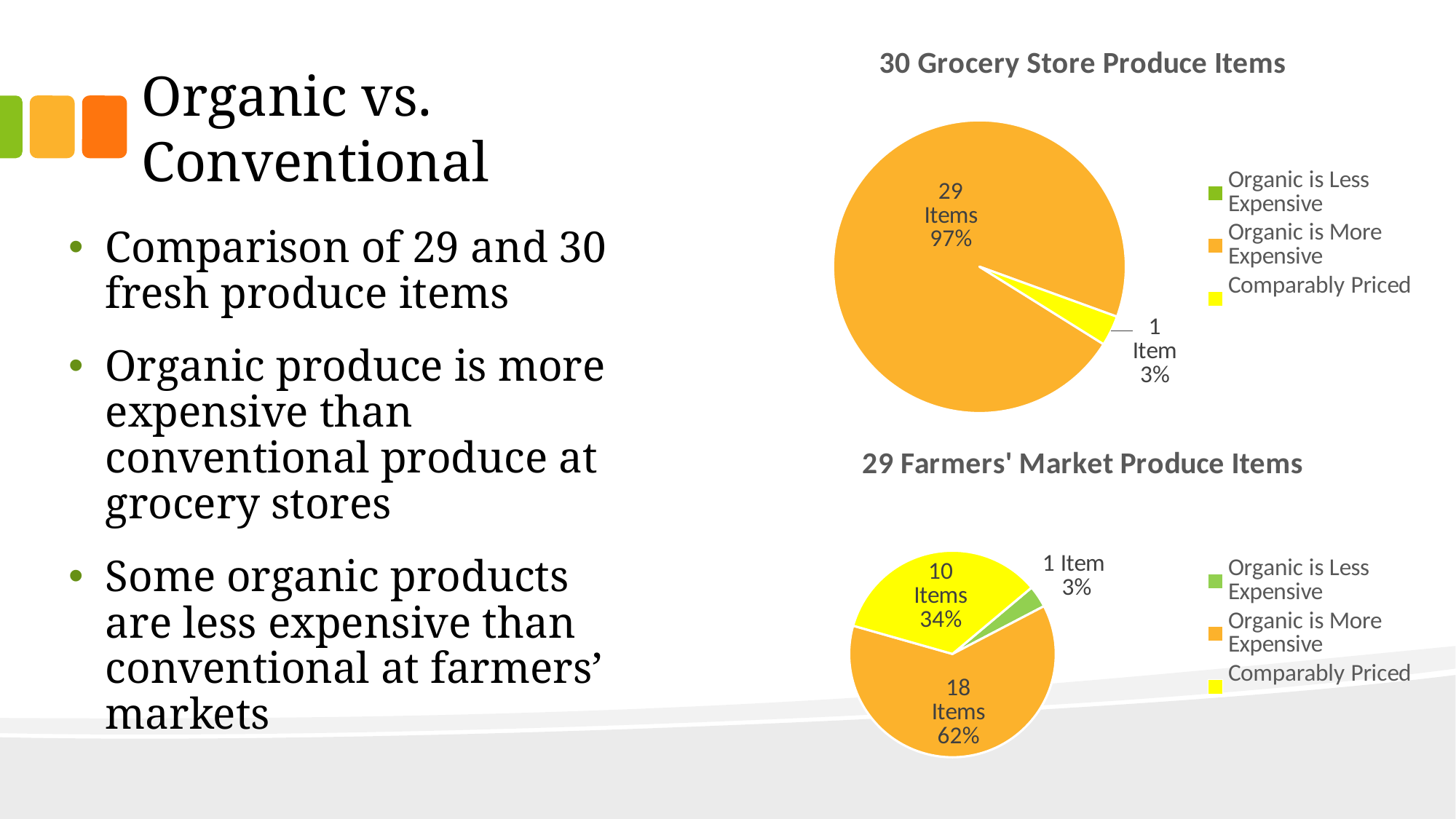
In the '29 Farmers' Market Produce Items' chart, how many more items are 'Organic is More Expensive' than 'Comparably Priced'? 8 In the '30 Grocery Store Produce Items' chart, what share of the pie is 'Comparably Priced'? 3% In the '29 Farmers' Market Produce Items' chart, which category has the largest slice? Organic is More Expensive What type of chart is the '30 Grocery Store Produce Items' chart? Pie chart In the '29 Farmers' Market Produce Items' chart, which category has the smallest slice? Organic is Less Expensive In the '29 Farmers' Market Produce Items' chart, how many items are 'Comparably Priced'? 10 Items In the '29 Farmers' Market Produce Items' chart, what percentage is 'Organic is Less Expensive'? 3% In the '29 Farmers' Market Produce Items' chart, which is larger: 'Comparably Priced' or 'Organic is Less Expensive'? Comparably Priced In the '30 Grocery Store Produce Items' chart, what percentage is labelled for 'Organic is More Expensive'? 97% How many entries does the legend of the '29 Farmers' Market Produce Items' chart list? 3 In the '30 Grocery Store Produce Items' chart, how many items fall under 'Organic is More Expensive'? 29 Items In the '29 Farmers' Market Produce Items' chart, what share of the pie is 'Organic is More Expensive'? 62%